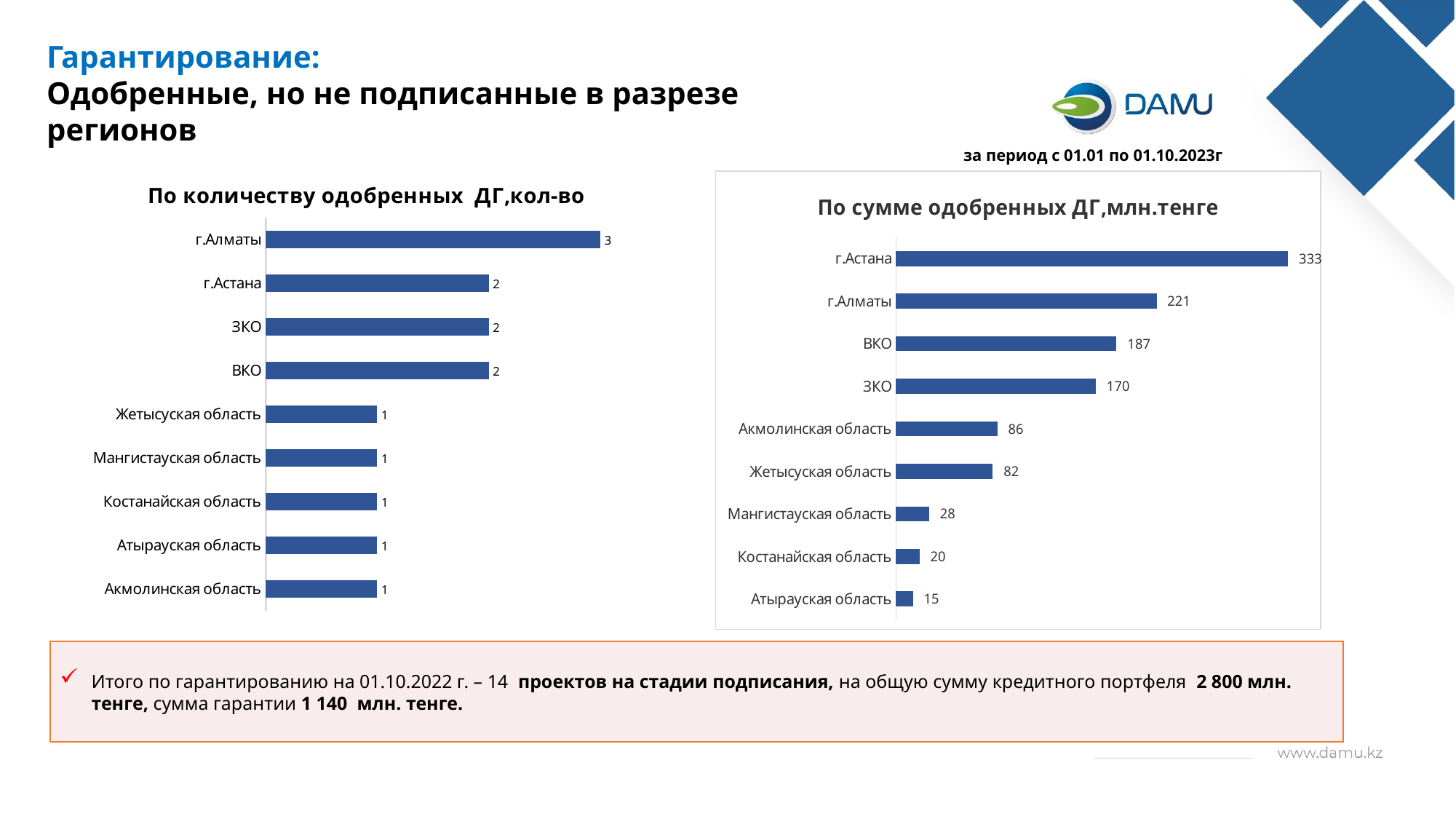
In the chart 'По количеству одобренных ДГ,кол-во', what is the value for г.Алматы? 3 In the chart 'По сумме одобренных ДГ,млн.тенге', which is larger: Акмолинская область or Жетысуская область? Акмолинская область How many regions are shown in the chart 'По количеству одобренных ДГ,кол-во'? 9 In the chart 'По сумме одобренных ДГ,млн.тенге', which region has the highest value? г.Астана What type of chart is 'По сумме одобренных ДГ,млн.тенге'? Bar chart In the chart 'По сумме одобренных ДГ,млн.тенге', what is the difference between ЗКО and Костанайская область? 150 What period is stated above the charts on the slide? за период с 01.01 по 01.10.2023г In the chart 'По сумме одобренных ДГ,млн.тенге', what is the value for Мангистауская область? 28 In the chart 'По сумме одобренных ДГ,млн.тенге', which region has the lowest value? Атырауская область In the chart 'По сумме одобренных ДГ,млн.тенге', what is the difference between г.Астана and г.Алматы? 112 In the chart 'По сумме одобренных ДГ,млн.тенге', what is the value for ВКО? 187 In the chart 'По количеству одобренных ДГ,кол-во', which region has the highest value? г.Алматы